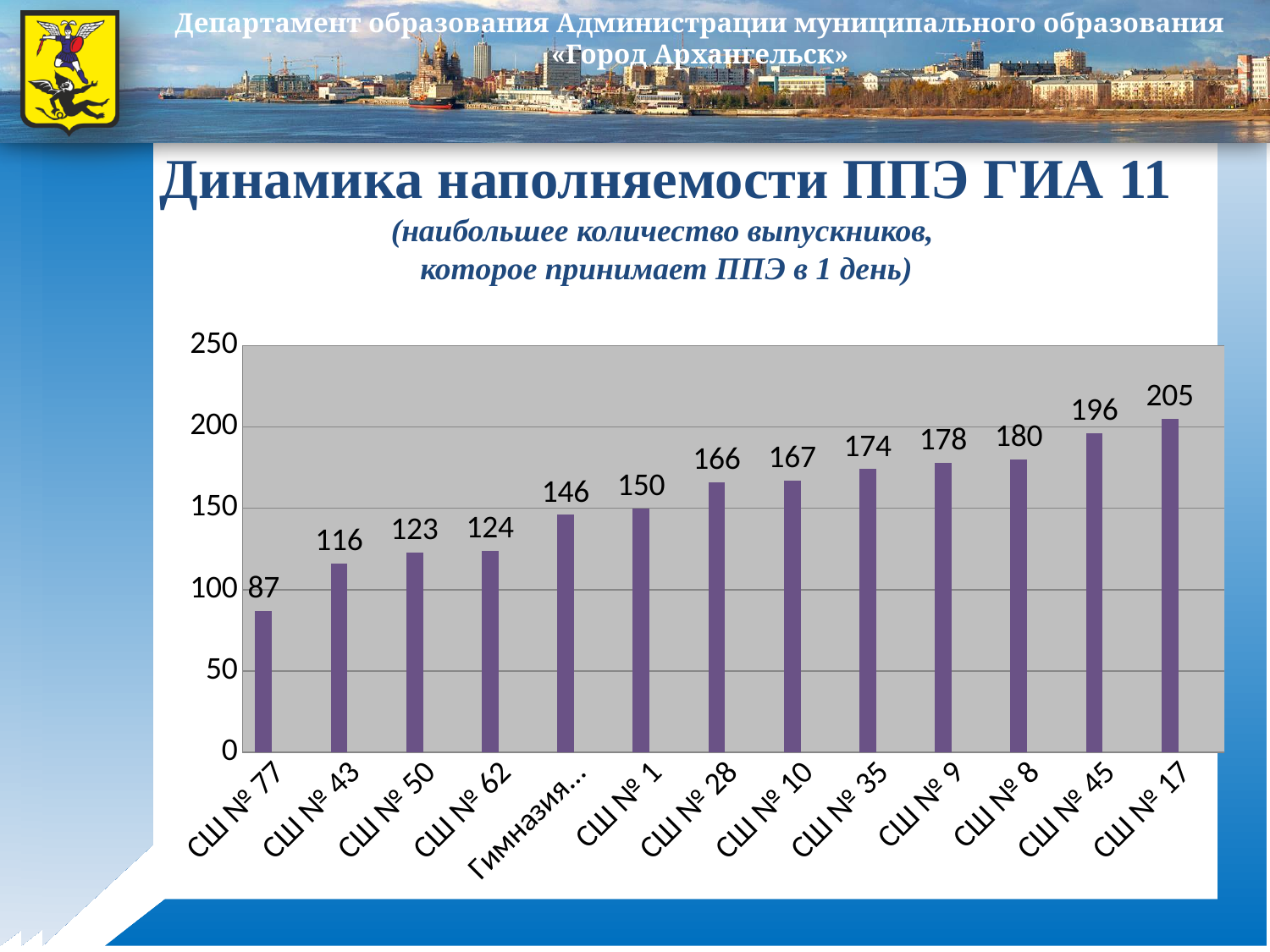
What is the value for СШ № 45? 196 What is the difference between the values for СШ № 17 and СШ № 77? 118 What kind of chart is shown on the slide? bar chart What is the difference between the values for СШ № 1 and СШ № 50? 27 What is the value for СШ № 77? 87 What is the value for СШ № 28? 166 How many categories are shown on the x axis? 13 Which is larger, the value for СШ № 43 or the value for СШ № 62? СШ № 62 Which category has the lowest value? СШ № 77 Do the values rise or fall from left to right along the x axis? rise Is the value for СШ № 35 greater or less than 150? greater Which category has the highest value? СШ № 17